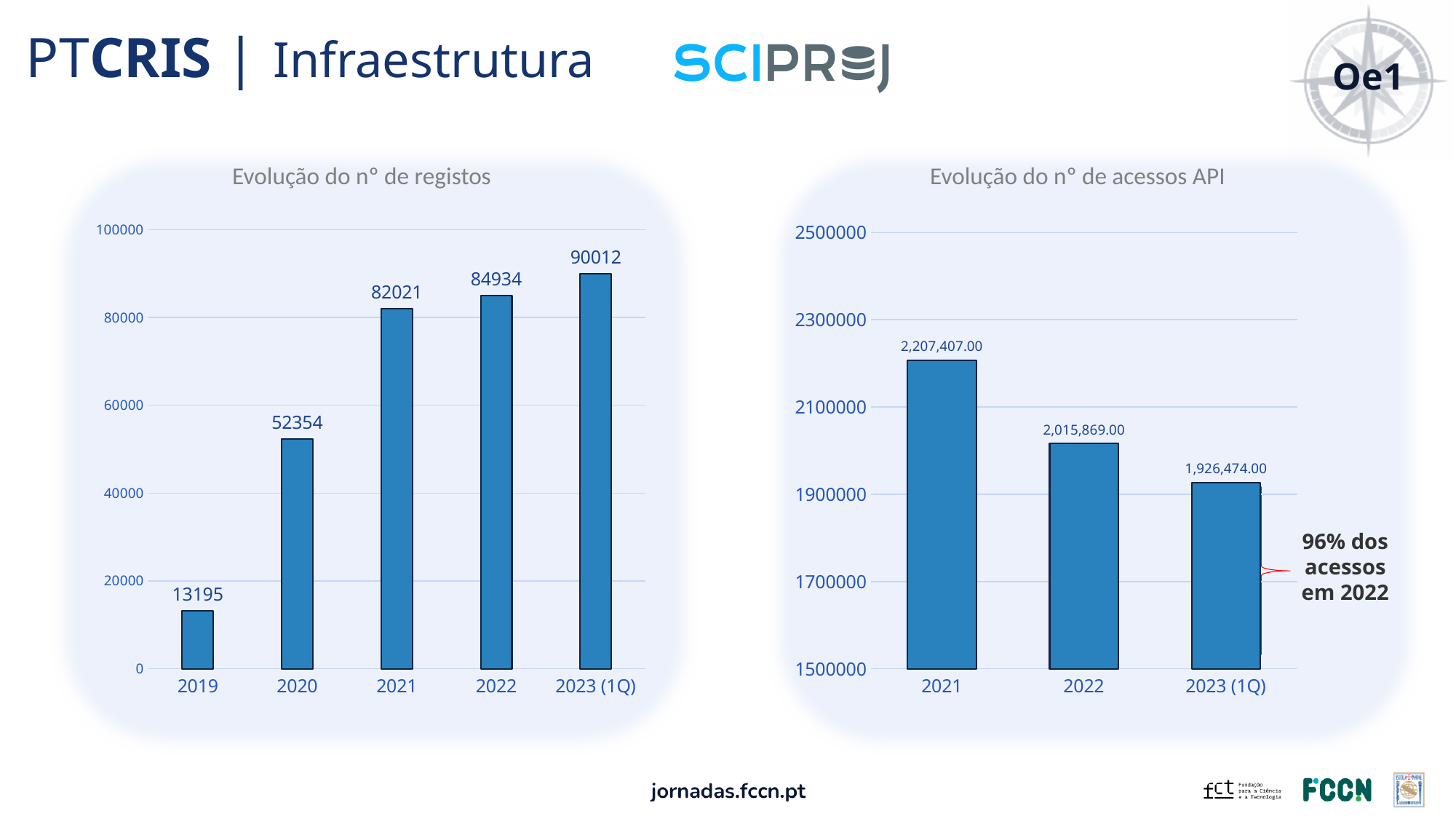
In the 'Evolução do nº de registos' chart, what is the difference between the values for 2020 and 2019? 39159 In the 'Evolução do nº de registos' chart, which year has the highest value? 2023 (1Q) In the 'Evolução do nº de acessos API' chart, what is the value for 2022? 2,015,869.00 What kind of chart is the 'Evolução do nº de acessos API' chart? bar chart In the 'Evolução do nº de registos' chart, how many bars are plotted? 5 In the 'Evolução do nº de registos' chart, which year has the lowest value? 2019 In the 'Evolução do nº de acessos API' chart, do the values rise or fall from 2021 to 2023 (1Q)? fall In the 'Evolução do nº de acessos API' chart, which year has the highest value? 2021 In the 'Evolução do nº de acessos API' chart, what is the difference between the values for 2021 and 2023 (1Q)? 280,933.00 In the 'Evolução do nº de registos' chart, what is the value for 2021? 82021 In the 'Evolução do nº de registos' chart, do the values rise or fall from 2019 to 2023 (1Q)? rise In the 'Evolução do nº de registos' chart, what is the value for 2019? 13195